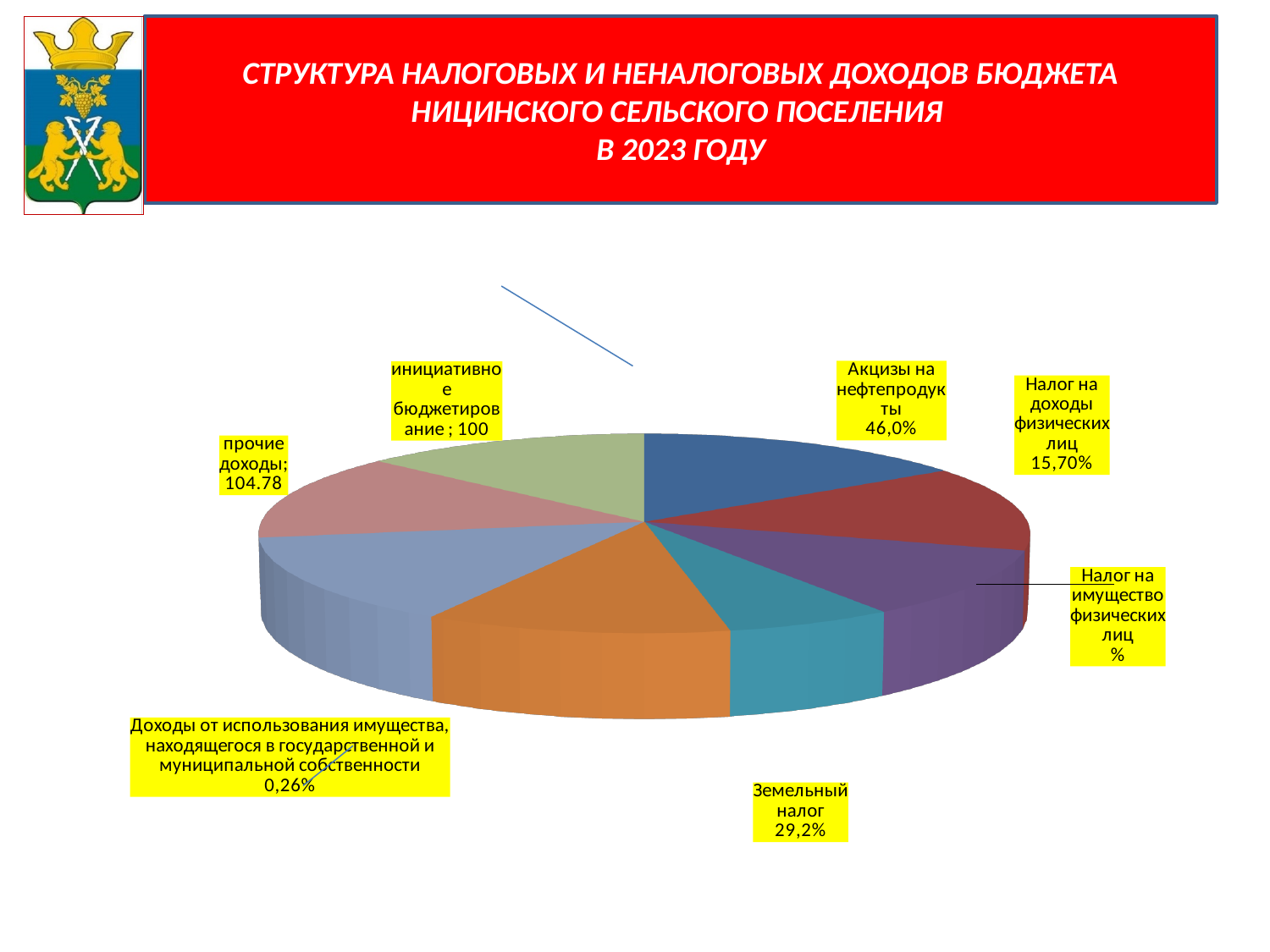
What share is labelled for Акцизы на нефтепродукты? 46,0% What share is labelled for Земельный налог? 29,2% What value is labelled for инициативное бюджетирование? 100 What year does the chart title refer to? 2023 What value is labelled for прочие доходы? 104.78 According to the labels, which is larger: Земельный налог or Налог на доходы физических лиц? Земельный налог What share is labelled for Налог на доходы физических лиц? 15,70% What is the difference between the labelled shares of Акцизы на нефтепродукты and Земельный налог? 16,8% What share is labelled for Доходы от использования имущества, находящегося в государственной и муниципальной собственности? 0,26% What kind of chart is shown on the slide? pie chart Which label on the chart has no numeric value printed next to it? Налог на имущество физических лиц According to the labels, which is larger: Акцизы на нефтепродукты or Земельный налог? Акцизы на нефтепродукты